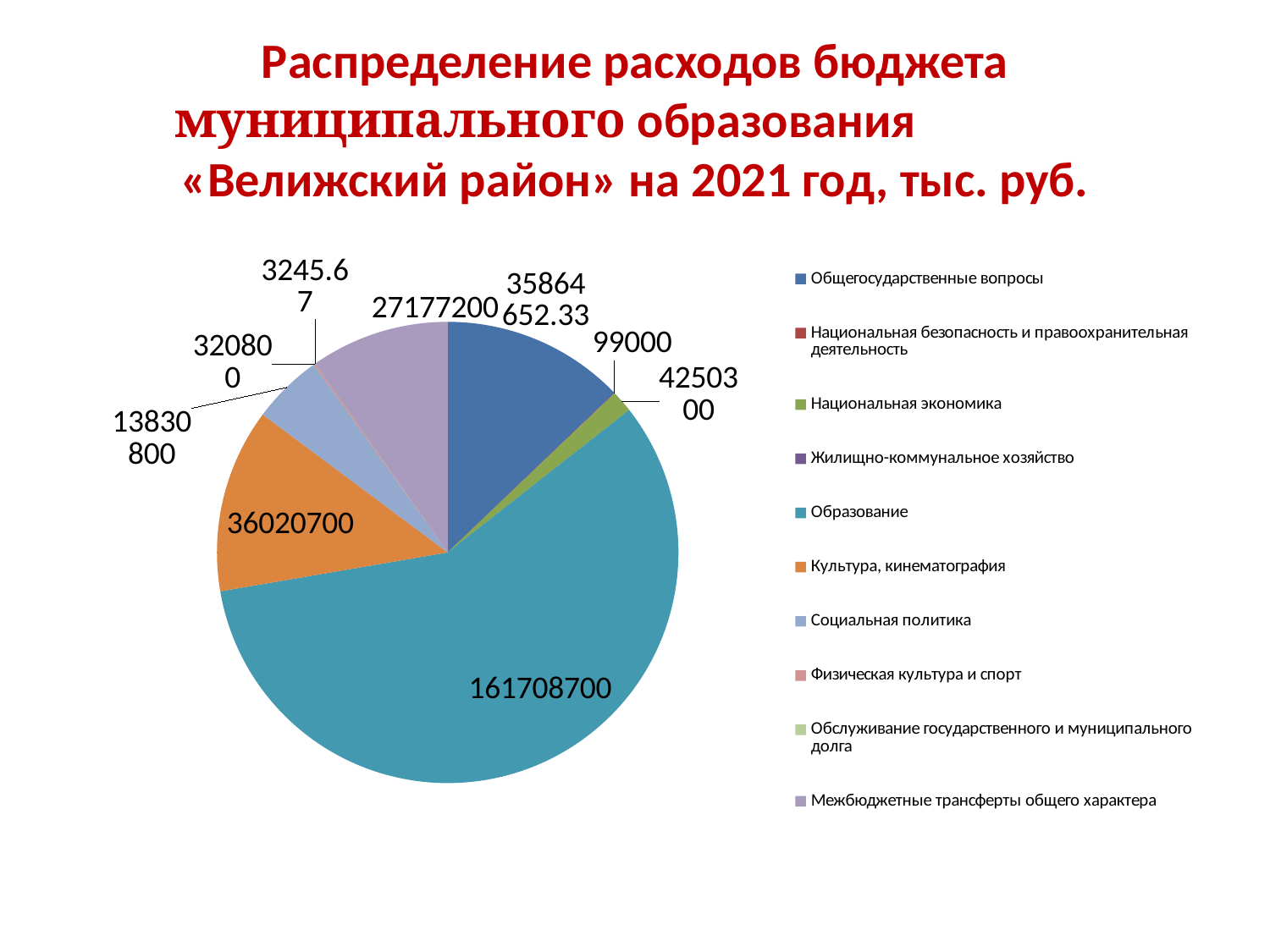
Which is larger: Культура, кинематография or Межбюджетные трансферты общего характера? Культура, кинематография What is the value shown for Культура, кинематография? 36020700 What is the value shown for Общегосударственные вопросы? 35864652.33 What is the difference between the values for Культура, кинематография and Межбюджетные трансферты общего характера? 8843500 What type of chart is shown on the slide? pie chart What is the value shown for Социальная политика? 13830800 What is the value shown for Межбюджетные трансферты общего характера? 27177200 What year does the chart title say the budget expenditure distribution is for? 2021 What is the difference between the values for Образование and Культура, кинематография? 125688000 Which category has the largest slice of the pie? Образование What is the value shown for Образование? 161708700 How many categories does the legend list? 10